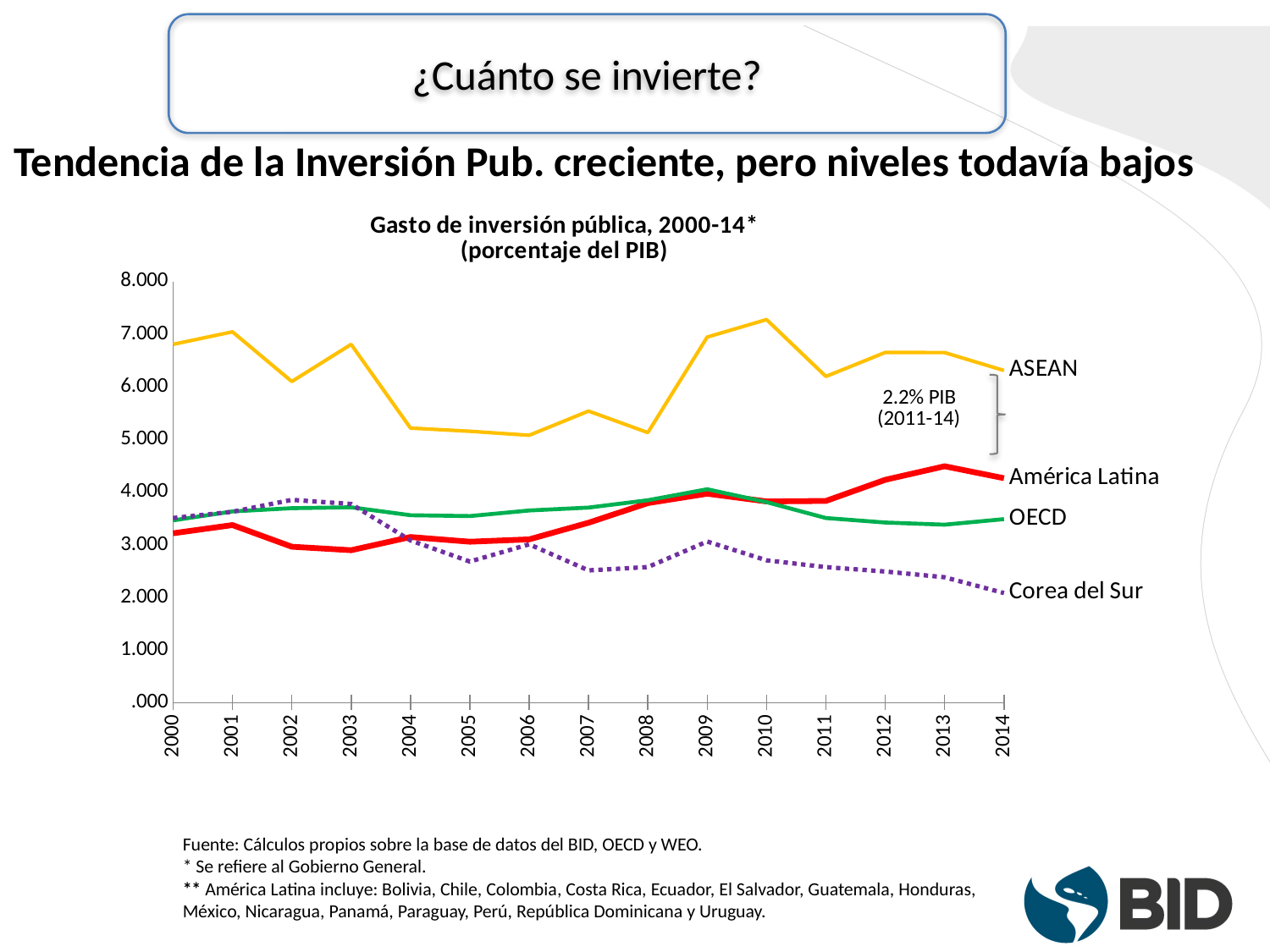
Which is larger in 2010, the value for ASEAN or the value for OECD? ASEAN Is the value for América Latina in 2013 greater or less than 4.000? greater Is the value for ASEAN in 2010 greater or less than 7.000? greater Which series has the highest value in 2014? ASEAN What is the title of the chart? Gasto de inversión pública, 2000-14* (porcentaje del PIB) How many years are shown along the x axis of the chart? 15 Is the value for Corea del Sur in 2014 greater or less than 3.000? less How many series (lines) are plotted in the chart? 4 Which series has the lowest value in 2014? Corea del Sur What kind of chart is shown on the slide? line chart Does the Corea del Sur line generally rise or fall from 2003 to 2014? fall